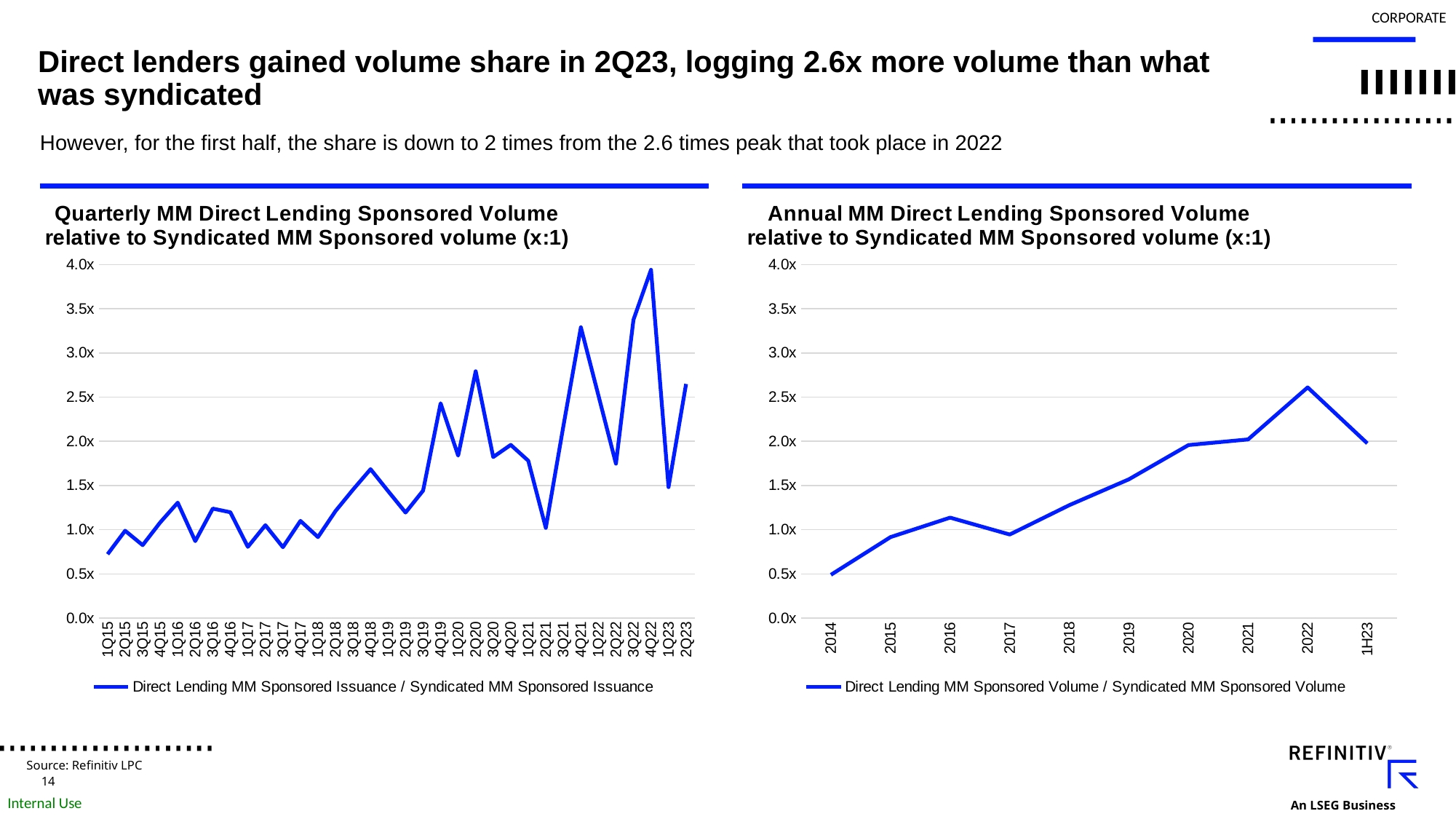
In the right chart (Annual), which year has the highest value? 2022 In the left chart (Quarterly), is the value for 1Q23 greater or less than 2.0x? less In the right chart, 'Annual MM Direct Lending Sponsored Volume relative to Syndicated MM Sponsored volume (x:1)', how many points are plotted along the x axis? 10 What kind of chart is the left chart, 'Quarterly MM Direct Lending Sponsored Volume relative to Syndicated MM Sponsored volume (x:1)'? line chart How many series does the legend of the right chart (Annual) list? 1 In the right chart (Annual), which year has the lowest value? 2014 In the left chart (Quarterly), which is larger, the value for 4Q21 or the value for 2Q21? 4Q21 In the right chart (Annual), which is larger, the value for 2022 or the value for 2017? 2022 In the right chart (Annual), is the value for 2020 greater or less than 1.5x? greater In the right chart (Annual), is the value for 2014 greater or less than 1.0x? less In the left chart (Quarterly), which quarter has the highest value? 4Q22